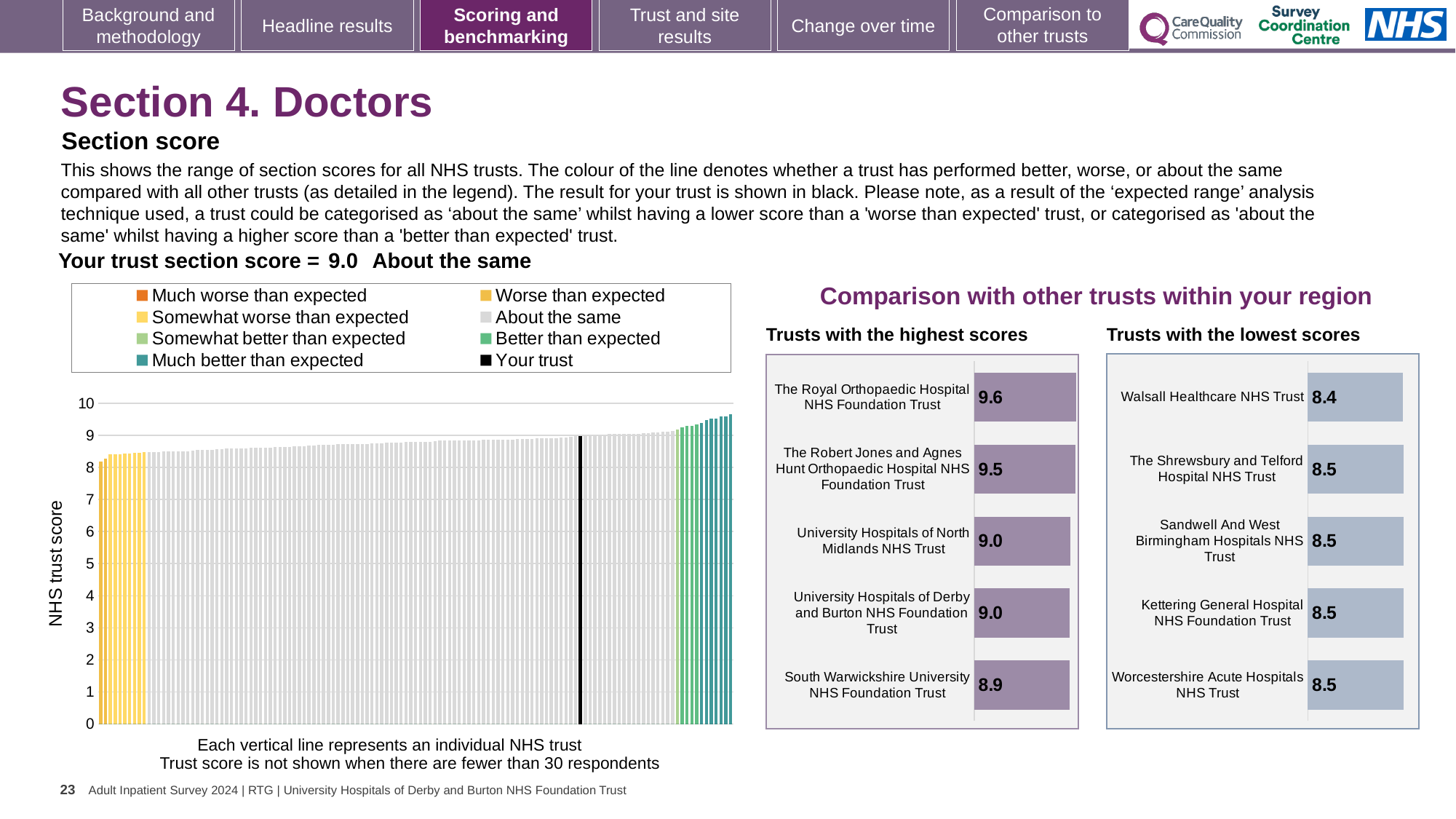
In the large chart on the left, do the trust scores rise or fall from left to right? Rise In the 'Trusts with the highest scores' chart, what is the score for South Warwickshire University NHS Foundation Trust? 8.9 In the 'Trusts with the highest scores' chart, what is the score for The Royal Orthopaedic Hospital NHS Foundation Trust? 9.6 In the 'Trusts with the highest scores' chart, what is the difference between the scores of The Royal Orthopaedic Hospital NHS Foundation Trust and South Warwickshire University NHS Foundation Trust? 0.7 In the 'Trusts with the lowest scores' chart, which has the larger score: Walsall Healthcare NHS Trust or Kettering General Hospital NHS Foundation Trust? Kettering General Hospital NHS Foundation Trust In the 'Trusts with the highest scores' chart, which trust has the highest score? The Royal Orthopaedic Hospital NHS Foundation Trust What kind of chart is the large chart on the left showing NHS trust scores? Bar chart In the 'Trusts with the lowest scores' chart, what is the difference between the scores of Worcestershire Acute Hospitals NHS Trust and Walsall Healthcare NHS Trust? 0.1 In the 'Trusts with the lowest scores' chart, which trust has the lowest score? Walsall Healthcare NHS Trust In the 'Trusts with the lowest scores' chart, what is the score for Walsall Healthcare NHS Trust? 8.4 In the 'Trusts with the highest scores' chart, how many trusts are listed? 5 How many entries does the legend of the large chart on the left list? 8